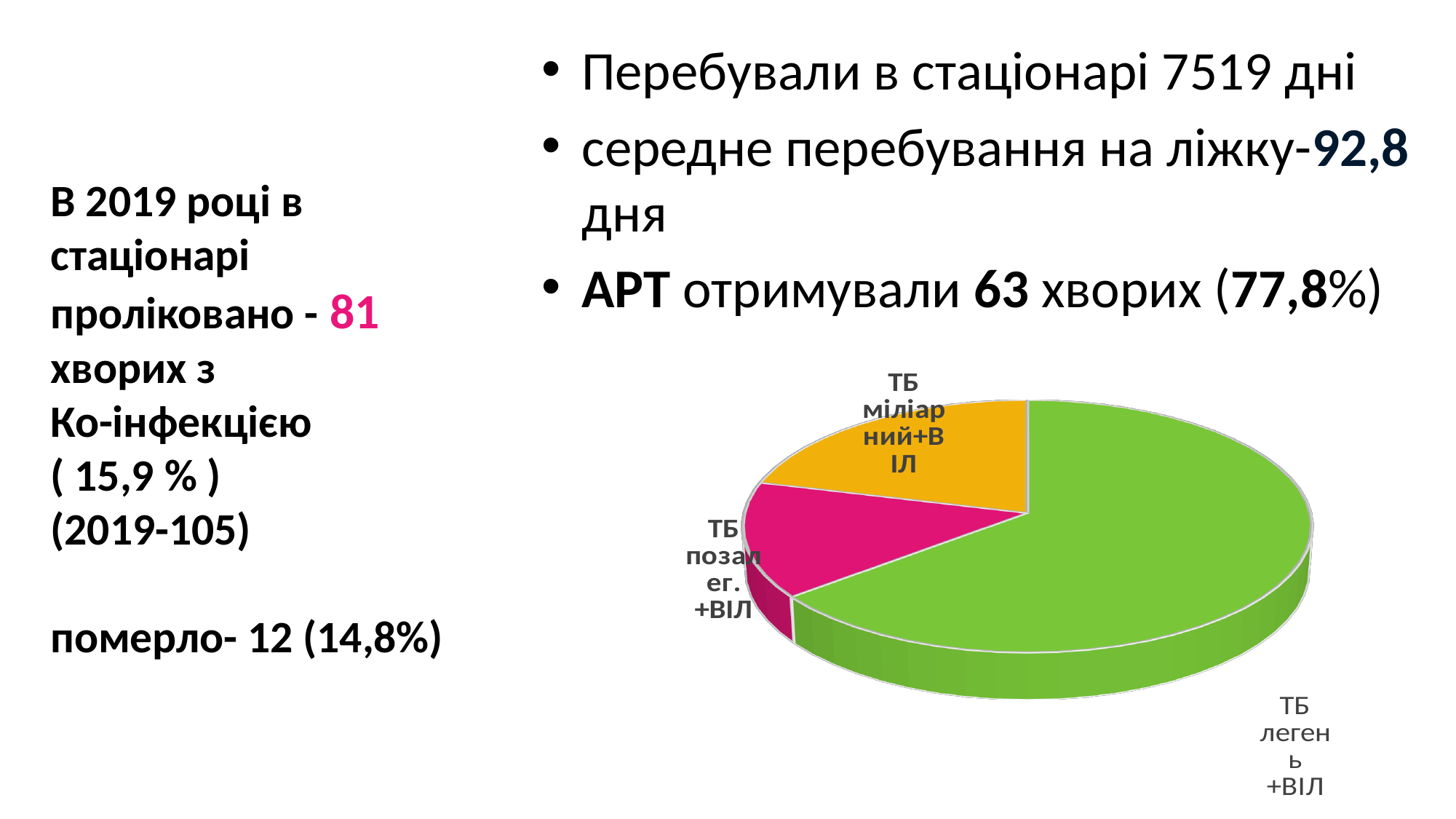
Which category has the smallest slice in the pie chart? ТБ позалег. +ВІЛ What colour is the ТБ легень +ВІЛ slice in the pie chart? green What kind of chart is shown on the slide? pie chart Does the ТБ легень +ВІЛ slice take up more or less than half of the pie chart? more Which slice is larger in the pie chart: ТБ легень +ВІЛ or ТБ міліарний+ВІЛ? ТБ легень +ВІЛ Which category has the largest slice in the pie chart? ТБ легень +ВІЛ Which slice is larger in the pie chart: ТБ міліарний+ВІЛ or ТБ позалег. +ВІЛ? ТБ міліарний+ВІЛ What colour is the ТБ міліарний+ВІЛ slice in the pie chart? orange How many slices does the pie chart have? 3